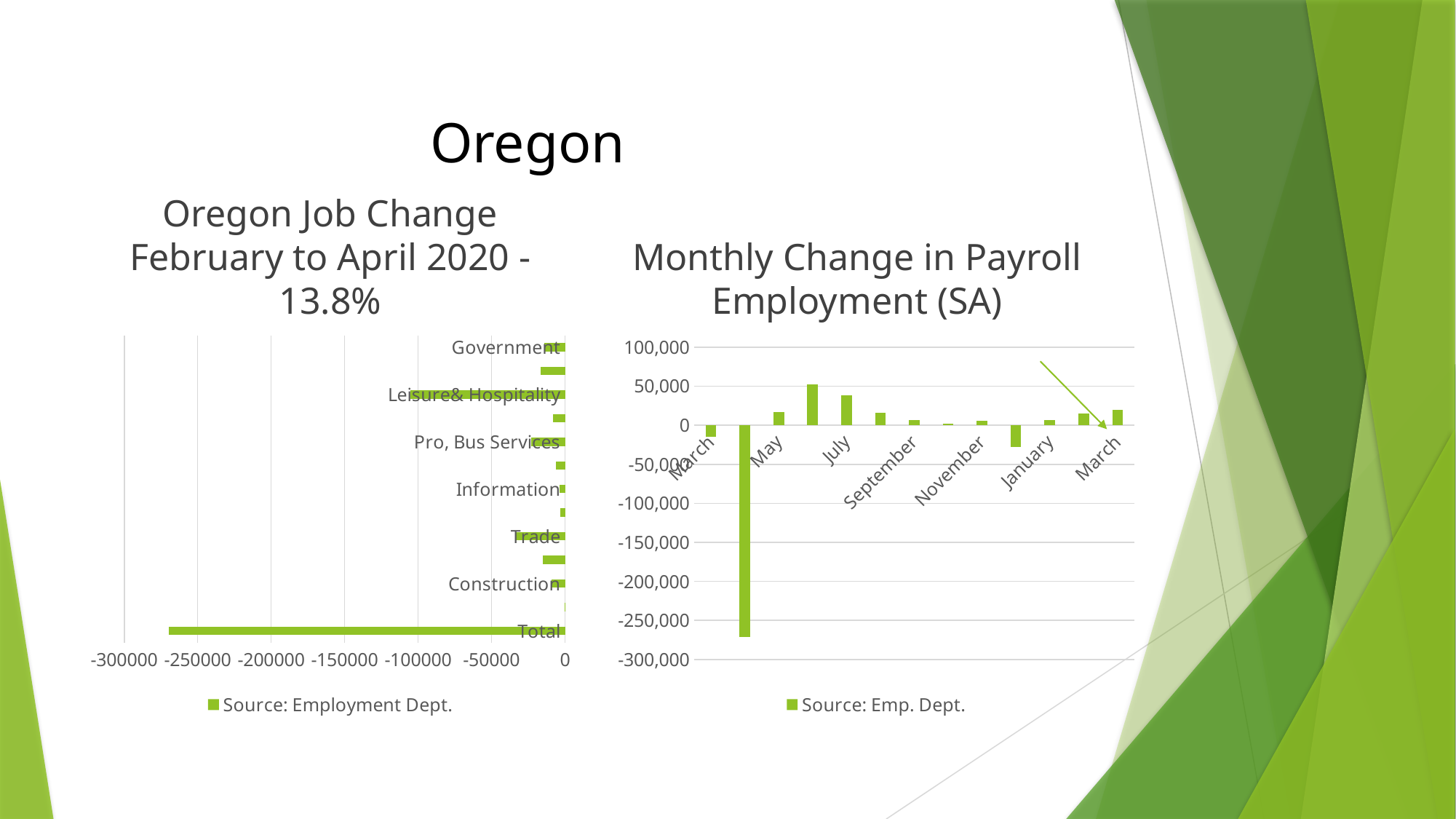
In the right chart, is the value for July greater or less than 50,000? less In the left chart, which is lower: Leisure & Hospitality or Government? Leisure & Hospitality In the right chart, is the lowest bar greater or less than -250,000? less In the left chart, is the value for Leisure & Hospitality greater or less than -150000? greater What kind of chart is the 'Monthly Change in Payroll Employment (SA)' chart on the right? Bar chart How many series does the legend of the right chart list? 1 What kind of chart is the 'Oregon Job Change February to April 2020 - 13.8%' chart on the left? Bar chart In the right chart, which is larger: the value for July or the value for May? July What is the legend entry shown under the left chart? Source: Employment Dept. In the left chart, which labeled category has the lowest (most negative) value? Total